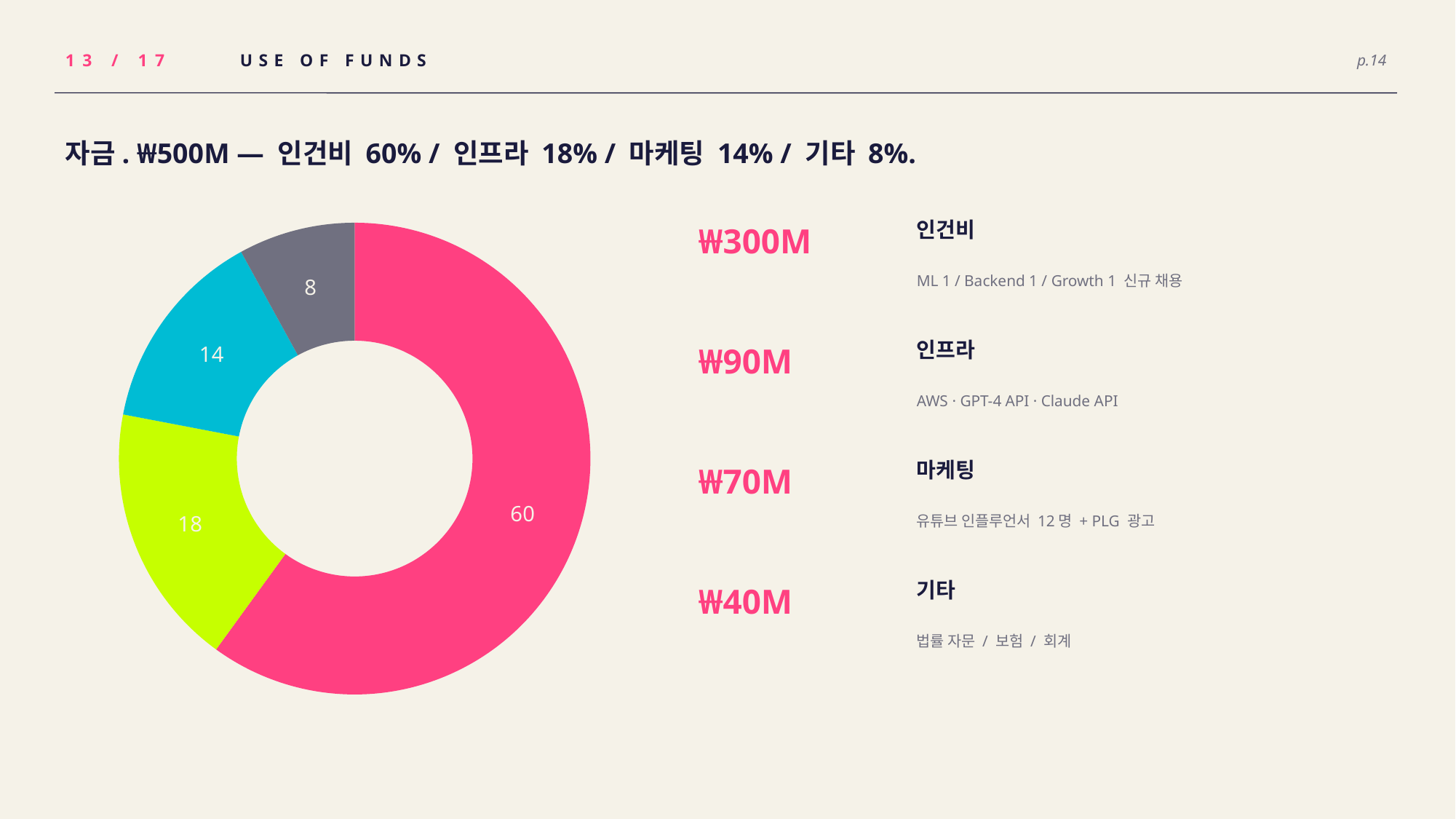
What value is labelled on the largest slice of the donut chart? 60 What is the difference in percentage points between the 인건비 slice (60) and the 인프라 slice (18)? 42 Which category has the smallest share of the funds in the donut chart? 기타 What kind of chart is shown on the slide? Donut (pie) chart How many slices does the donut chart have? 4 What share of the funds does 인프라 take according to the chart? 18% Which slice is larger, the one labelled 14 or the one labelled 18? 18 Which category has the largest share of the funds in the donut chart? 인건비 What colour is the largest slice (60) of the donut chart? Pink What value is labelled on the smallest slice of the donut chart? 8 What colour is the slice labelled 8 in the donut chart? Grey What share of the funds does 마케팅 take according to the chart? 14%